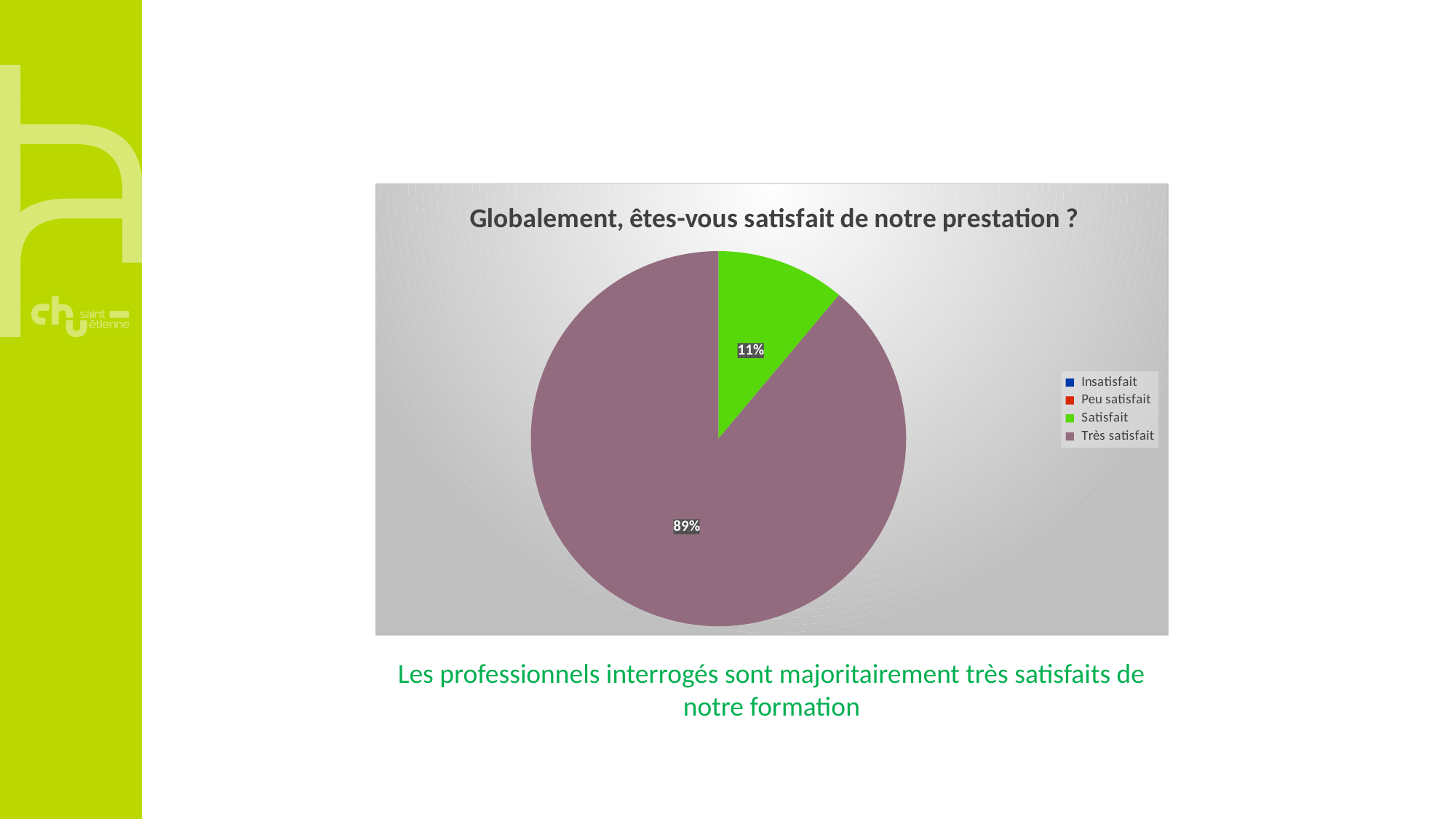
What share of the pie is labelled for 'Très satisfait'? 89% What is the difference in percentage points between the 'Très satisfait' and 'Satisfait' slices? 78 How many slices with a visible data label does the pie have? 2 What share of the pie is labelled for 'Satisfait'? 11% What kind of chart is shown on the slide? pie chart Which category has the largest slice of the pie? Très satisfait Which is larger, the 'Satisfait' slice or the 'Très satisfait' slice? Très satisfait What is the title of the chart? Globalement, êtes-vous satisfait de notre prestation ? How many categories does the legend list? 4 What colour is the 'Satisfait' slice? green